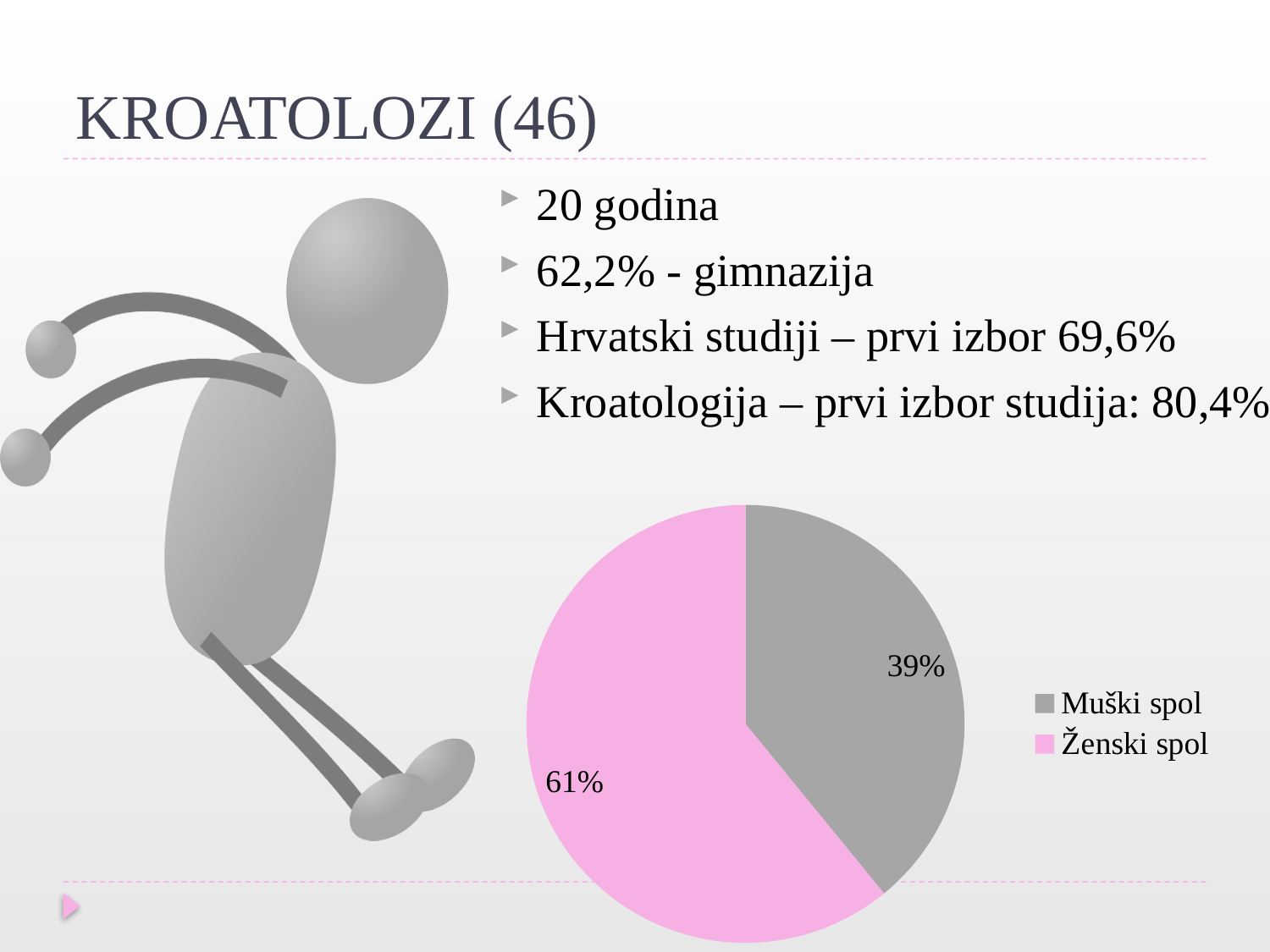
Which category has the largest slice of the pie? Ženski spol What share of the pie does Muški spol have? 39% Which category has the smallest slice of the pie? Muški spol How many slices does the pie chart have? 2 What colour is the Muški spol slice? grey What share of the pie does Ženski spol have? 61% What is the difference in percentage points between the Ženski spol and Muški spol slices? 22 What colour is the Ženski spol slice? pink What kind of chart is shown on the slide? pie chart Which is larger, the Muški spol slice or the Ženski spol slice? Ženski spol How many entries does the legend list? 2